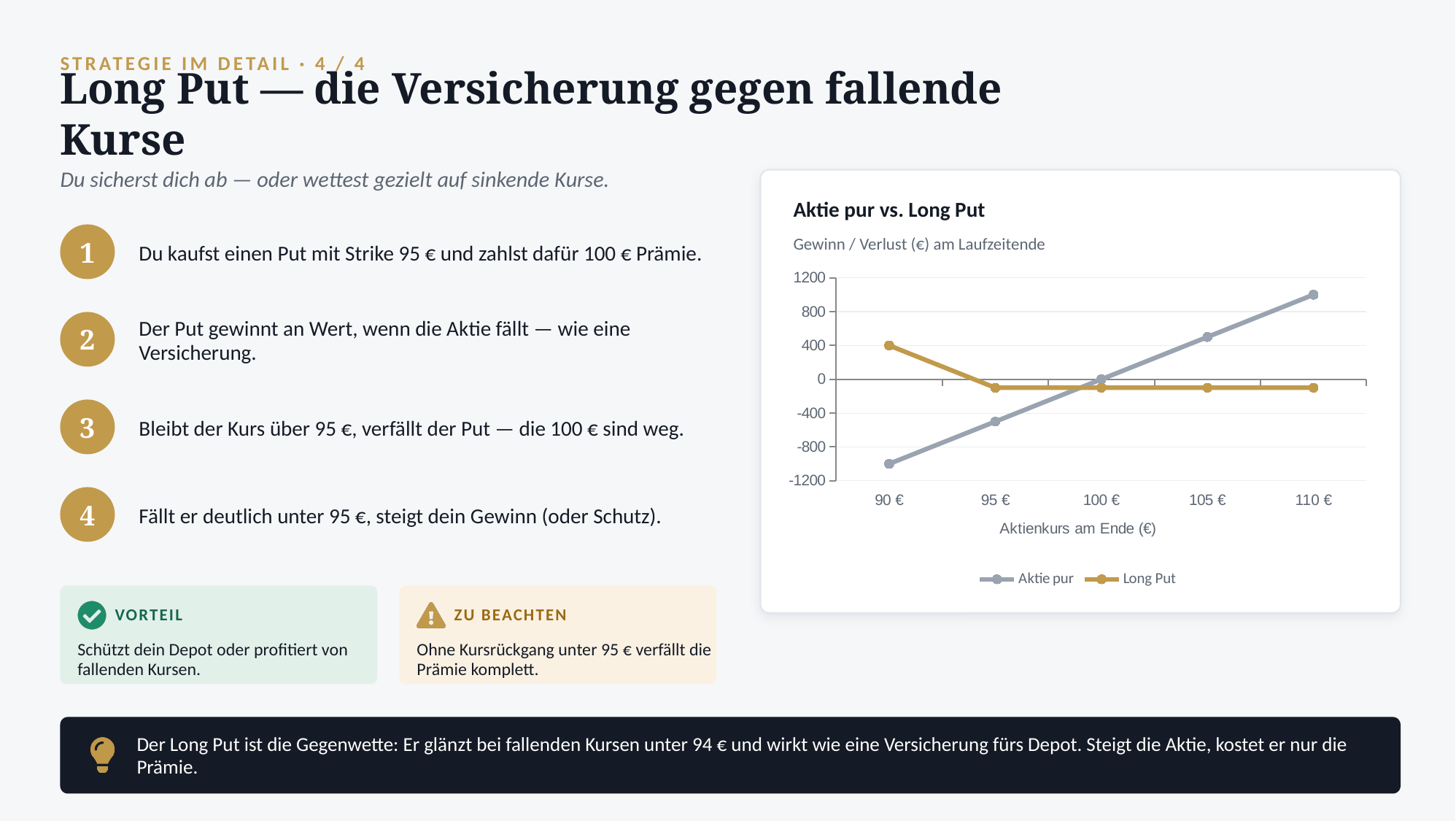
Does the Aktie pur series rise or fall as the share price increases from 90 € to 110 €? rise Is the value for Aktie pur at 110 € greater or less than 800? greater What is the label of the x axis? Aktienkurs am Ende (€) What kind of chart is shown on the slide? line chart How many series does the chart legend list? 2 What is the title of the chart? Aktie pur vs. Long Put What is the value of the Aktie pur series at 100 €? 0 At 90 €, which series has the higher value, Aktie pur or Long Put? Long Put What is the value of the Long Put series at 90 €? 400 Is the value for Long Put at 105 € greater or less than 0? less How many share-price points are plotted along the x axis? 5 Is the value for Aktie pur at 90 € greater or less than -800? less